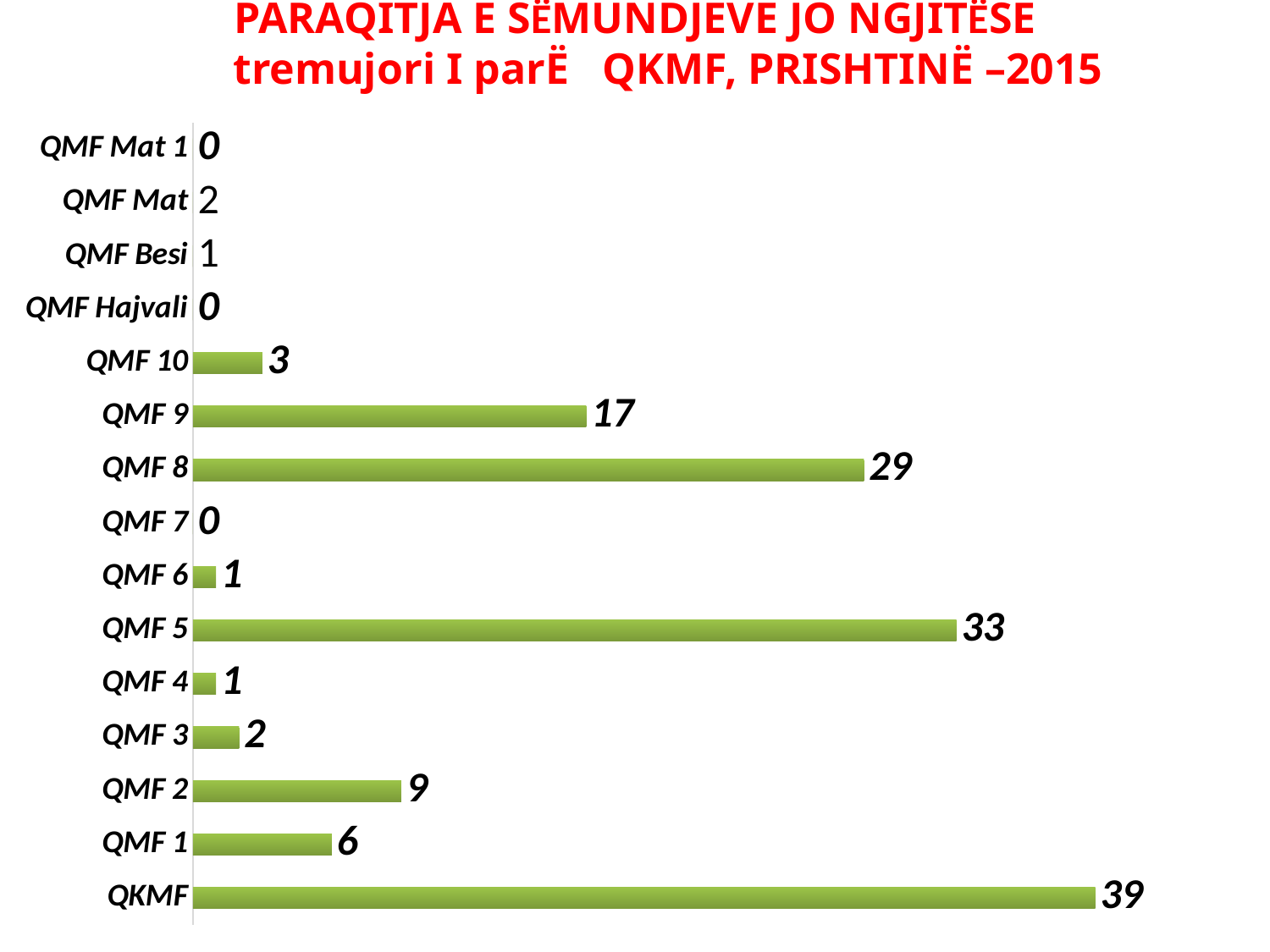
What is the value for QMF 5? 33 What is the difference between the values for QMF 8 and QMF 9? 12 What is the difference between the values for QKMF and QMF 5? 6 How many categories are shown in the chart? 15 Which category has the highest value? QKMF Which is larger, the value for QMF 8 or the value for QMF 5? QMF 5 Which is larger, the value for QMF 2 or the value for QMF 1? QMF 2 How many categories have a value of 0? 3 What is the value for QMF 9? 17 What kind of chart is shown on the slide? Bar chart What is the value for QMF Mat? 2 What is the value for QKMF? 39